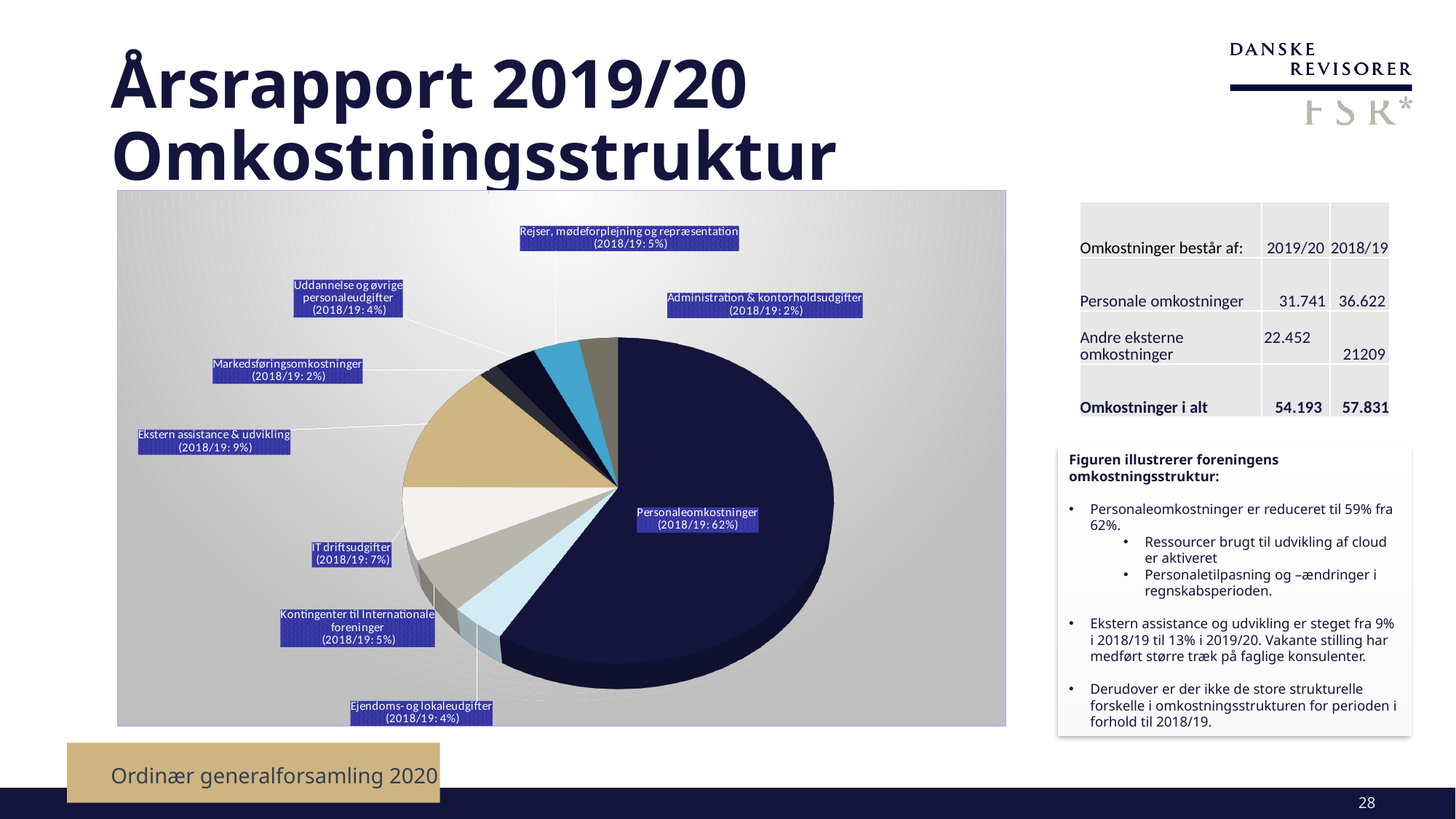
What 2018/19 share is printed in the label for Personaleomkostninger? 62% What 2018/19 share is printed in the label for Kontingenter til Internationale foreninger? 5% What 2018/19 share is printed in the label for IT driftsudgifter? 7% What 2018/19 share is printed in the label for Ejendoms- og lokaleudgifter? 4% According to the printed 2018/19 labels, what is the difference in percentage points between Personaleomkostninger and Ekstern assistance & udvikling? 53 percentage points What 2018/19 share is printed in the label for Administration & kontorholdsudgifter? 2% What kind of chart is shown on the slide? pie chart Which category has the largest slice in the pie chart? Personaleomkostninger According to the printed 2018/19 labels, which is larger: Ekstern assistance & udvikling or IT driftsudgifter? Ekstern assistance & udvikling What 2018/19 share is printed in the label for Ekstern assistance & udvikling? 9% What colour is the Personaleomkostninger slice in the pie chart? dark navy blue How many categories (slices) are labelled in the pie chart? 9